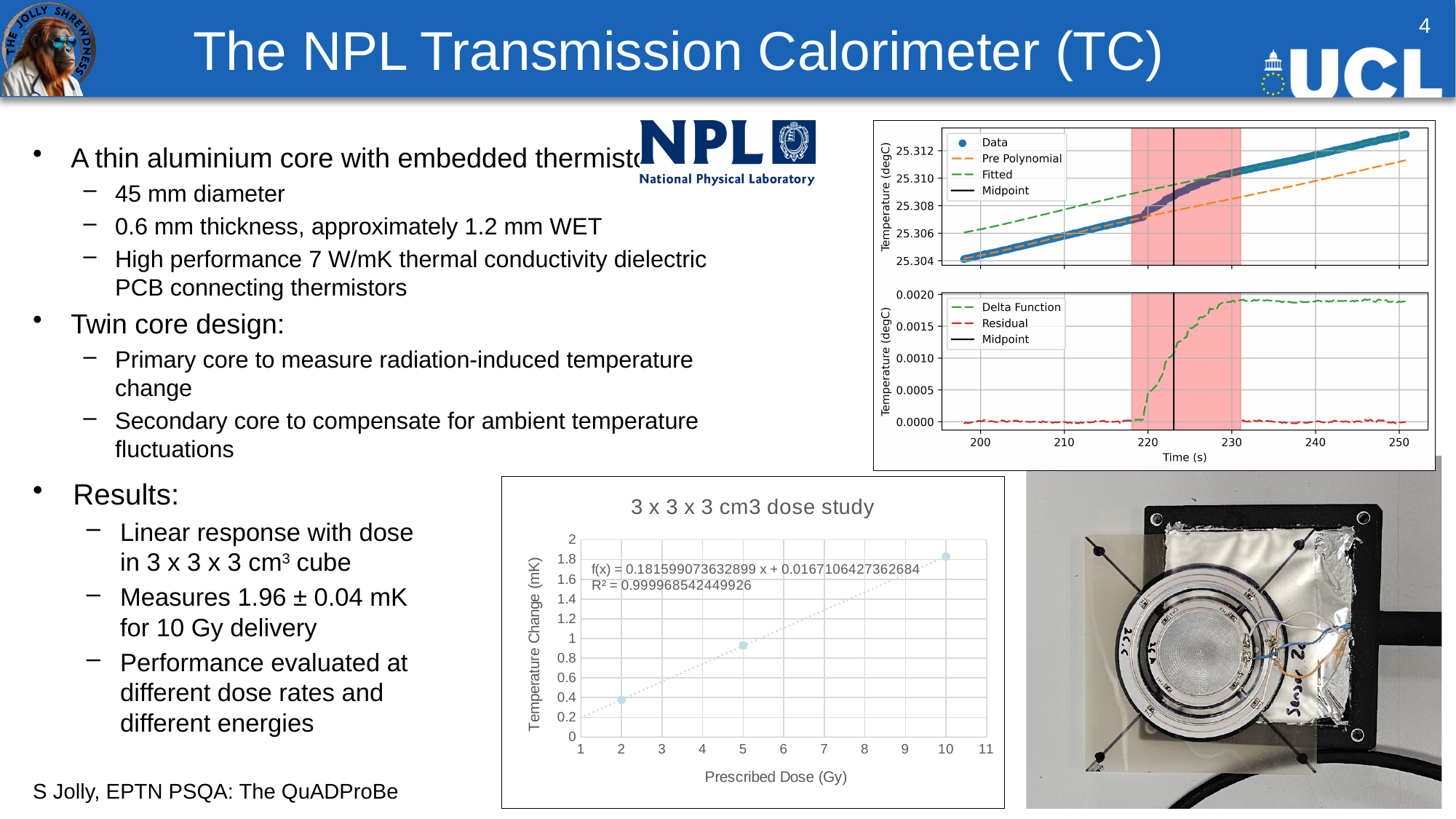
In the '3 x 3 x 3 cm3 dose study' chart, what R² value is printed for the fitted line? 0.999968542449926 In the top-right temperature chart, is the Delta Function value at 240 s greater or less than 0.0015? greater In the '3 x 3 x 3 cm3 dose study' chart, is the temperature change at 10 Gy greater or less than 1.6 mK? greater In the '3 x 3 x 3 cm3 dose study' chart, is the temperature change at 5 Gy greater or less than 0.8 mK? greater In the '3 x 3 x 3 cm3 dose study' chart, what is the label of the x axis? Prescribed Dose (Gy) In the '3 x 3 x 3 cm3 dose study' chart, how many data points are plotted? 3 In the '3 x 3 x 3 cm3 dose study' chart, which prescribed dose gives the highest temperature change? 10 Gy In the '3 x 3 x 3 cm3 dose study' chart, what kind of chart is shown? scatter chart In the top-right temperature chart, how many entries does the legend of the lower panel list? 3 In the '3 x 3 x 3 cm3 dose study' chart, does the temperature change rise or fall as the prescribed dose increases? rise In the top-right temperature chart, how many entries does the legend of the upper panel list? 4